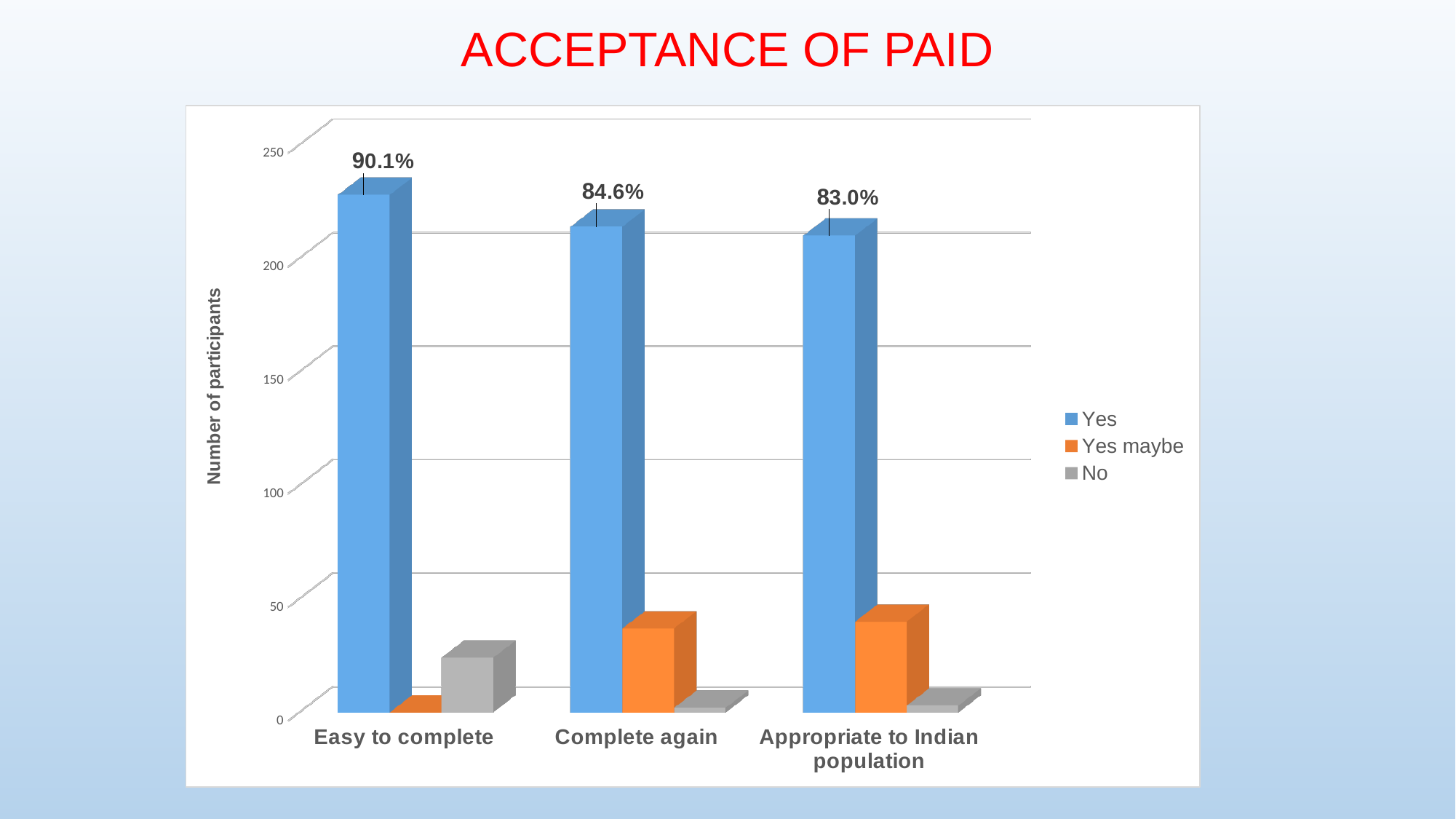
What is the data label on the Yes bar for Appropriate to Indian population? 83.0% How many series does the legend list? 3 In the Easy to complete category, which is larger: the Yes bar or the No bar? Yes Which category has the highest Yes value? Easy to complete How many categories are shown on the x axis? 3 What is the difference between the Yes labels for Easy to complete and Appropriate to Indian population? 7.1 percentage points Is the No value for Easy to complete greater or less than 50 on the Number of participants axis? less What is the data label on the Yes bar for Easy to complete? 90.1% What kind of chart is shown on the slide? Bar chart What is the data label on the Yes bar for Complete again? 84.6% Which category has the lowest Yes value? Appropriate to Indian population Is the Yes value for Easy to complete greater or less than 200 on the Number of participants axis? greater